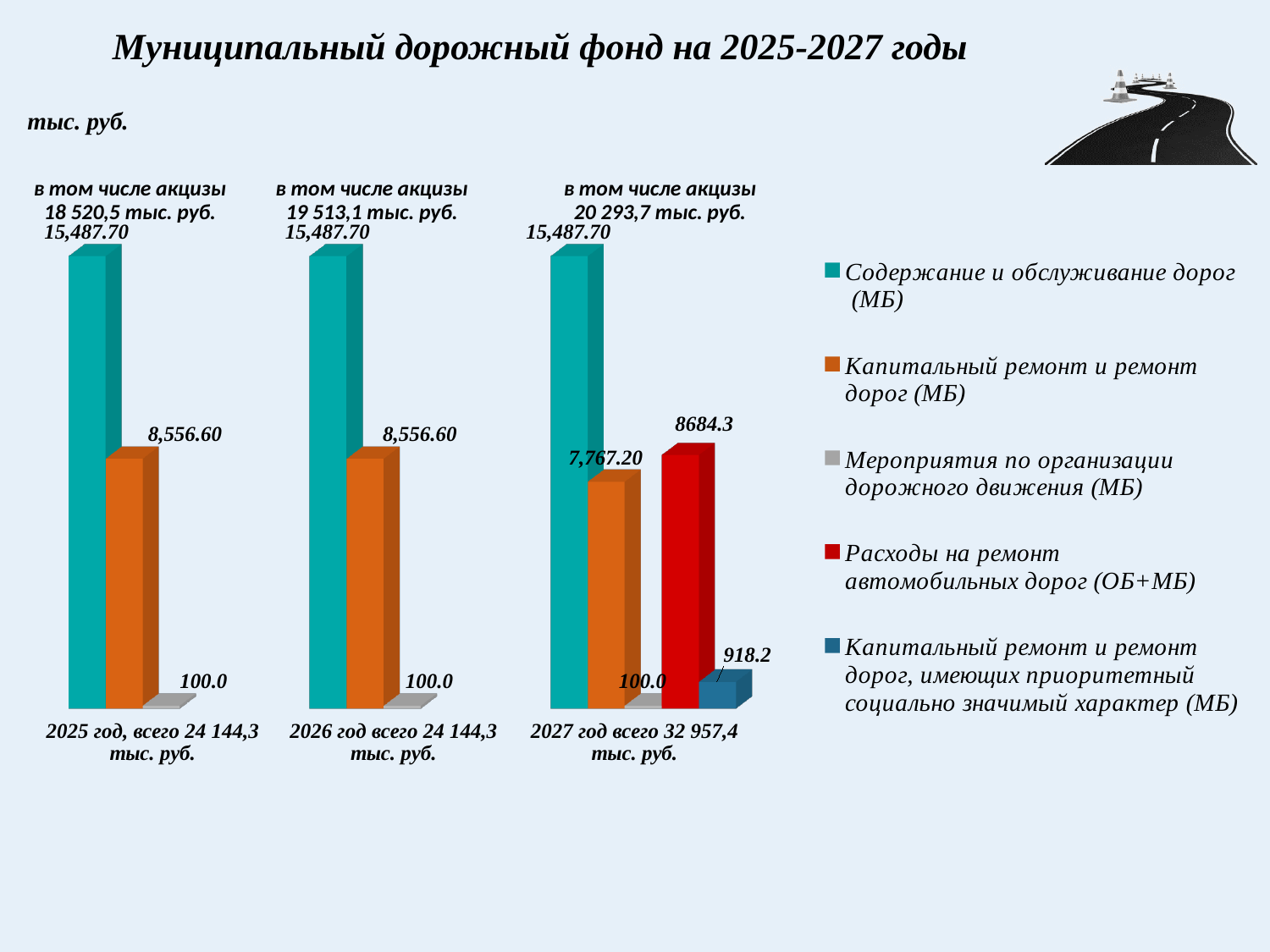
What is the value for "Расходы на ремонт автомобильных дорог (ОБ+МБ)" in 2027? 8684.3 What is the value for "Содержание и обслуживание дорог (МБ)" in 2025? 15,487.70 In 2027, which is larger: "Расходы на ремонт автомобильных дорог (ОБ+МБ)" or "Капитальный ремонт и ремонт дорог (МБ)"? Расходы на ремонт автомобильных дорог (ОБ+МБ) How many series does the legend list? 5 What kind of chart is shown on the slide? bar chart Which series has the highest value in 2027? Содержание и обслуживание дорог (МБ) Which series has the lowest value in 2025? Мероприятия по организации дорожного движения (МБ) What is the value for "Капитальный ремонт и ремонт дорог (МБ)" in 2027? 7,767.20 What is the value for "Капитальный ремонт и ремонт дорог, имеющих приоритетный социально значимый характер (МБ)" in 2027? 918.2 What is the difference between "Капитальный ремонт и ремонт дорог (МБ)" in 2026 and in 2027? 789.40 What is the title of the slide? Муниципальный дорожный фонд на 2025-2027 годы How many year groups are plotted on the chart? 3